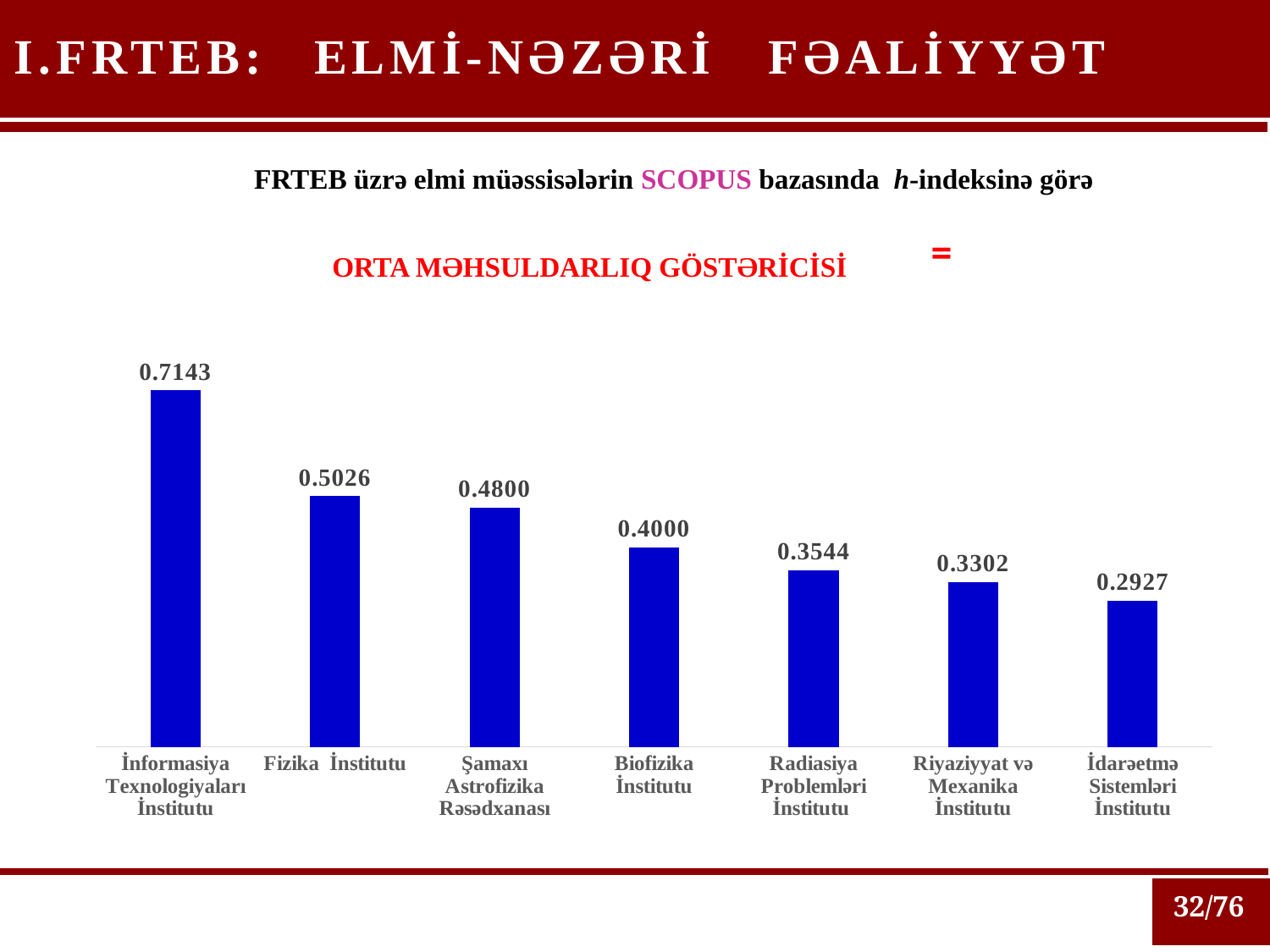
What is the value for Fizika İnstitutu? 0.5026 What is the difference between the values for İnformasiya Texnologiyaları İnstitutu and Fizika İnstitutu? 0.2117 What is the value for İdarəetmə Sistemləri İnstitutu? 0.2927 How many institutes are shown in the chart? 7 Which institute has the highest value? İnformasiya Texnologiyaları İnstitutu Which institute has the lowest value? İdarəetmə Sistemləri İnstitutu What is the difference between the values for Şamaxı Astrofizika Rəsədxanası and Biofizika İnstitutu? 0.0800 What kind of chart is shown on the slide? bar chart Which is larger, the value for Riyaziyyat və Mexanika İnstitutu or the value for Radiasiya Problemləri İnstitutu? Radiasiya Problemləri İnstitutu What is the value for Biofizika İnstitutu? 0.4000 Do the values rise or fall from left to right along the x axis? fall What is the value for Radiasiya Problemləri İnstitutu? 0.3544